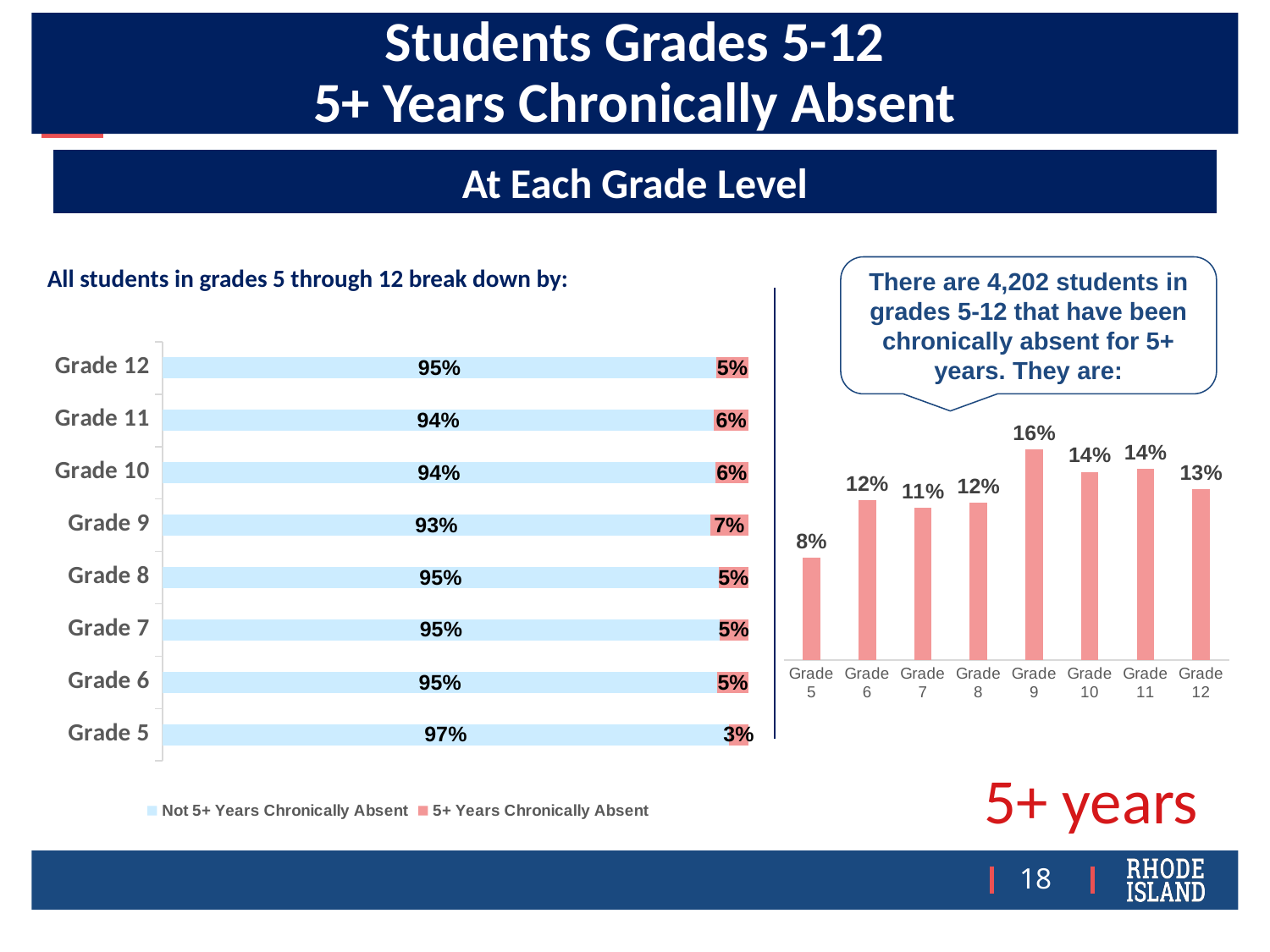
In the right chart, is the value for Grade 7 larger or smaller than the value for Grade 12? smaller In the right chart, what percentage of the 4,202 chronically absent students are in Grade 9? 16% In the left chart, which grade has the lowest share of students 5+ Years Chronically Absent? Grade 5 In the right chart, what is the difference between the values for Grade 9 and Grade 5? 8% In the left chart, what is the total of the two segments for Grade 11? 100% In the left chart, what percentage of Grade 9 students are 5+ Years Chronically Absent? 7% In the right chart, which grade has the lowest percentage? Grade 5 In the left chart, how many series does the legend list? 2 In the left chart, which grade has the highest share of students 5+ Years Chronically Absent? Grade 9 In the left chart, what is the difference between the Not 5+ Years Chronically Absent share for Grade 5 and for Grade 9? 4% In the left chart, what percentage of Grade 5 students are Not 5+ Years Chronically Absent? 97% What type of chart is the right chart? bar chart